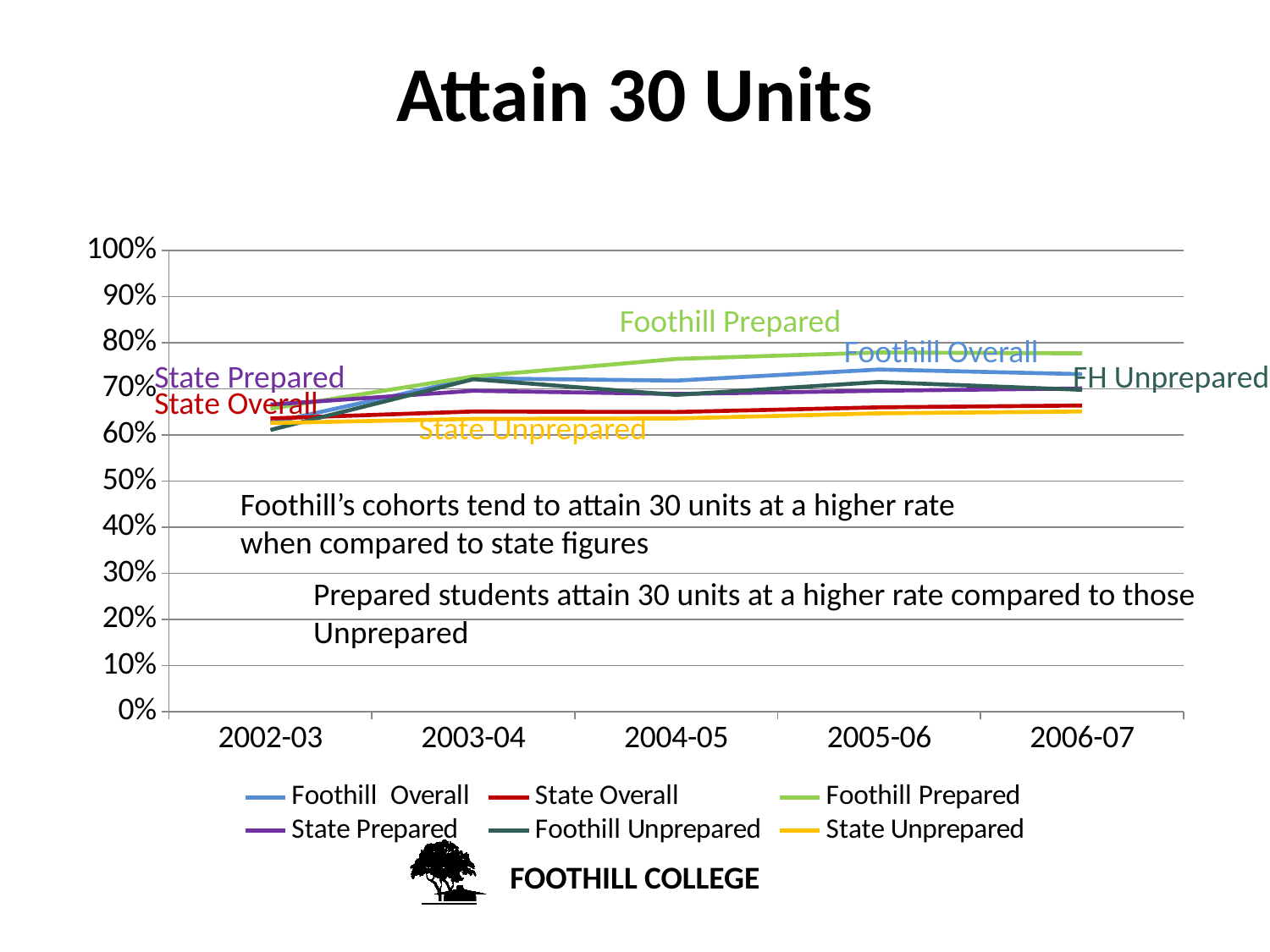
How many series does the legend list? 6 How many academic years are plotted along the x axis? 5 Which series is highest in 2006-07? Foothill Prepared Is the value for Foothill Overall in 2002-03 greater or less than 70%? less Does the Foothill Prepared line rise or fall from 2002-03 to 2006-07? rise Which series is highest in 2005-06? Foothill Prepared What is the title of the chart? Attain 30 Units Is the value for Foothill Prepared in 2006-07 greater or less than 70%? greater In 2006-07, which is larger: Foothill Prepared or State Prepared? Foothill Prepared Is the value for State Unprepared in 2006-07 greater or less than 70%? less In 2005-06, which is larger: Foothill Overall or State Overall? Foothill Overall What kind of chart is shown on the slide? line chart